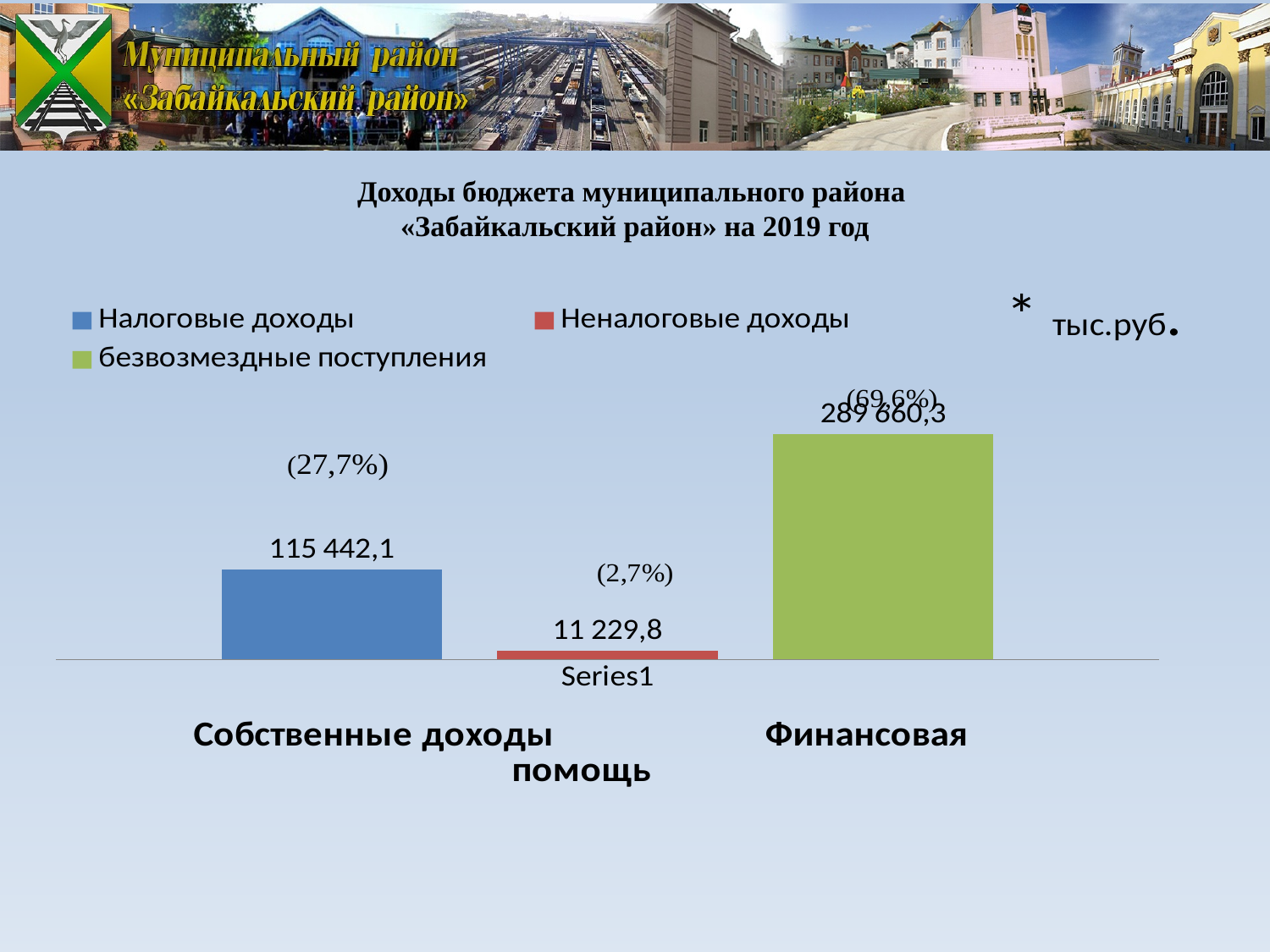
What percentage share is shown for безвозмездные поступления? 69,6% Which series has the highest value? безвозмездные поступления What is the value for Налоговые доходы? 115 442,1 Which series has the lowest value? Неналоговые доходы What is the value for Неналоговые доходы? 11 229,8 What is the difference between Налоговые доходы and Неналоговые доходы? 104 212,3 What unit of measurement is indicated for the chart values? тыс.руб. What is the difference between безвозмездные поступления and Налоговые доходы? 174 218,2 How many series does the legend list? 3 What kind of chart is shown on the slide? bar chart Which is larger, Налоговые доходы or Неналоговые доходы? Налоговые доходы What is the value for безвозмездные поступления? 289 660,3